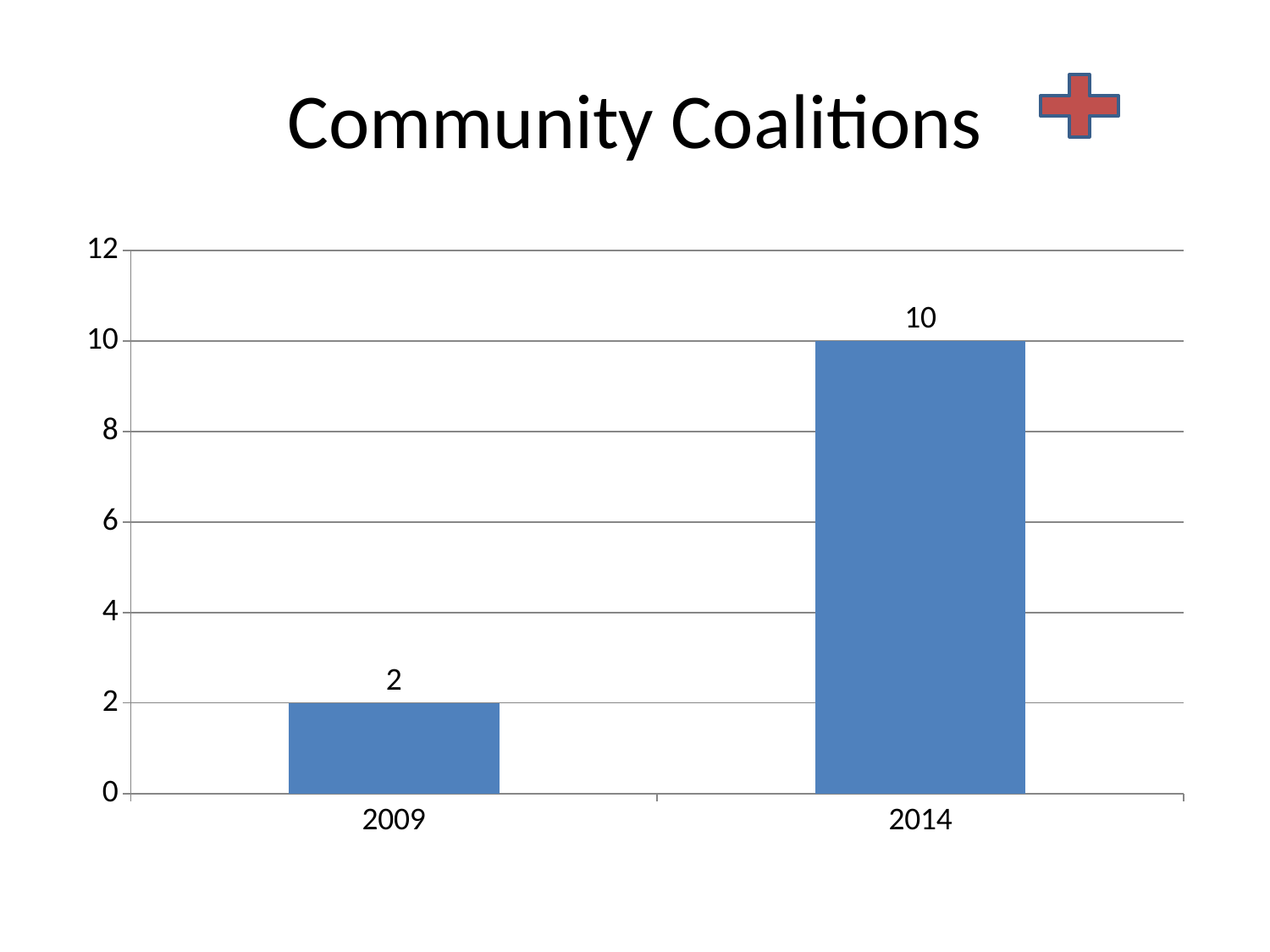
Which is larger, the value for 2009 or the value for 2014? 2014 Is the value for 2009 greater or less than 4? less What is the title of the slide? Community Coalitions Do the values rise or fall from 2009 to 2014? rise What is the difference between the values for 2014 and 2009? 8 What is the value for 2014? 10 How many categories are shown on the x axis? 2 What kind of chart is shown on the slide? bar chart Is the value for 2014 greater or less than 8? greater What is the value for 2009? 2 Which year has the lowest value? 2009 Which year has the highest value? 2014